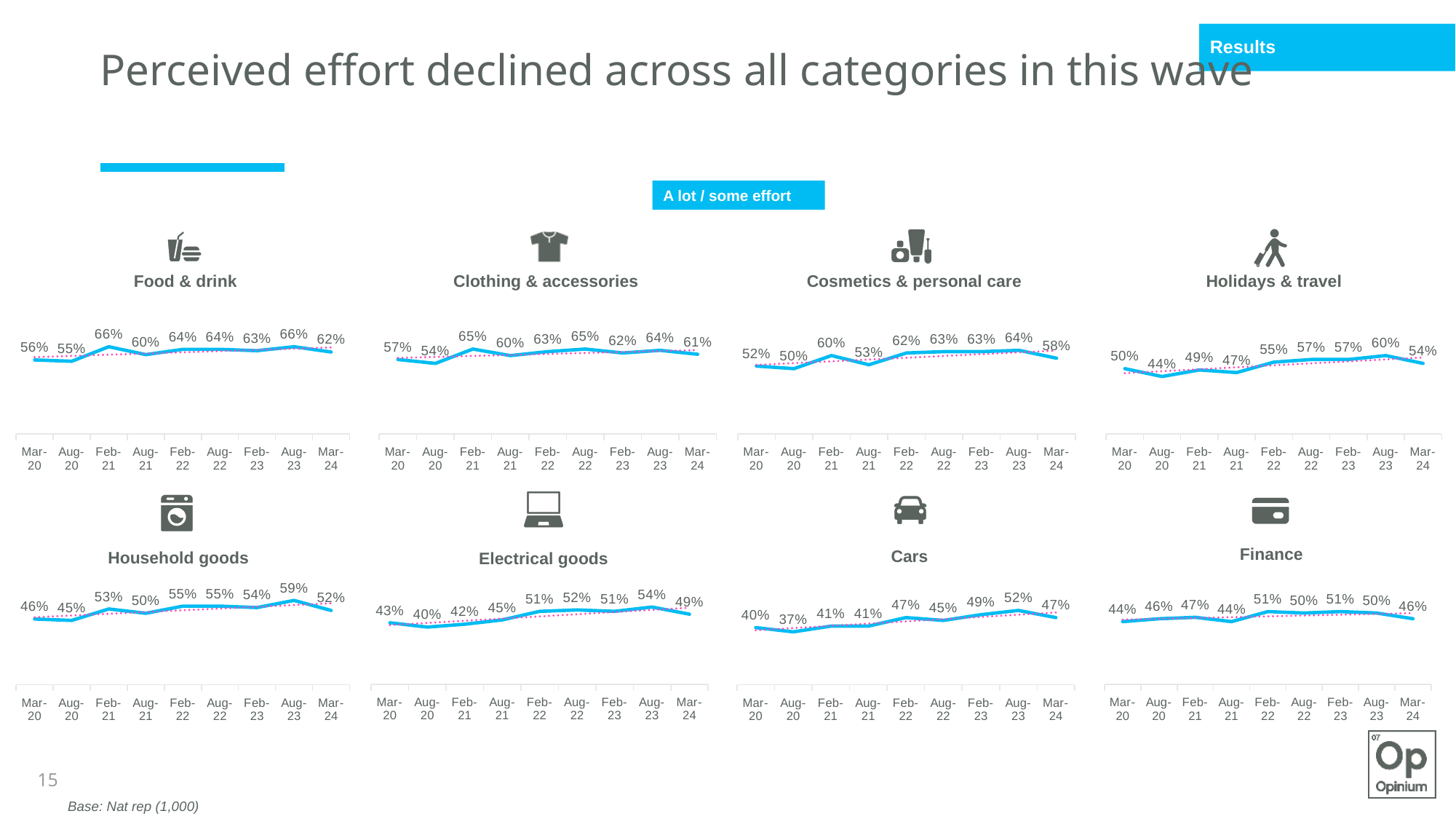
In the Finance chart, what is the value for Feb-22? 51% In the Holidays & travel chart, which period has the highest value? Aug-23 In the Cosmetics & personal care chart, which is larger, the value for Aug-23 or the value for Mar-24? Aug-23 In the Cars chart, what is the value for Aug-20? 37% In the Electrical goods chart, which period has the lowest value? Aug-20 In the Household goods chart, what is the difference between the Aug-23 value and the Mar-24 value? 7% What kind of chart is used for Food & drink? line chart In the Food & drink chart, what is the value for Mar-24? 62% In the Clothing & accessories chart, what is the difference between the Feb-21 value and the Aug-20 value? 11% What is the label shown in the blue box above the charts? A lot / some effort How many time periods are plotted in the Clothing & accessories chart? 9 In the Cars chart, does the value rise or fall from Aug-23 to Mar-24? fall